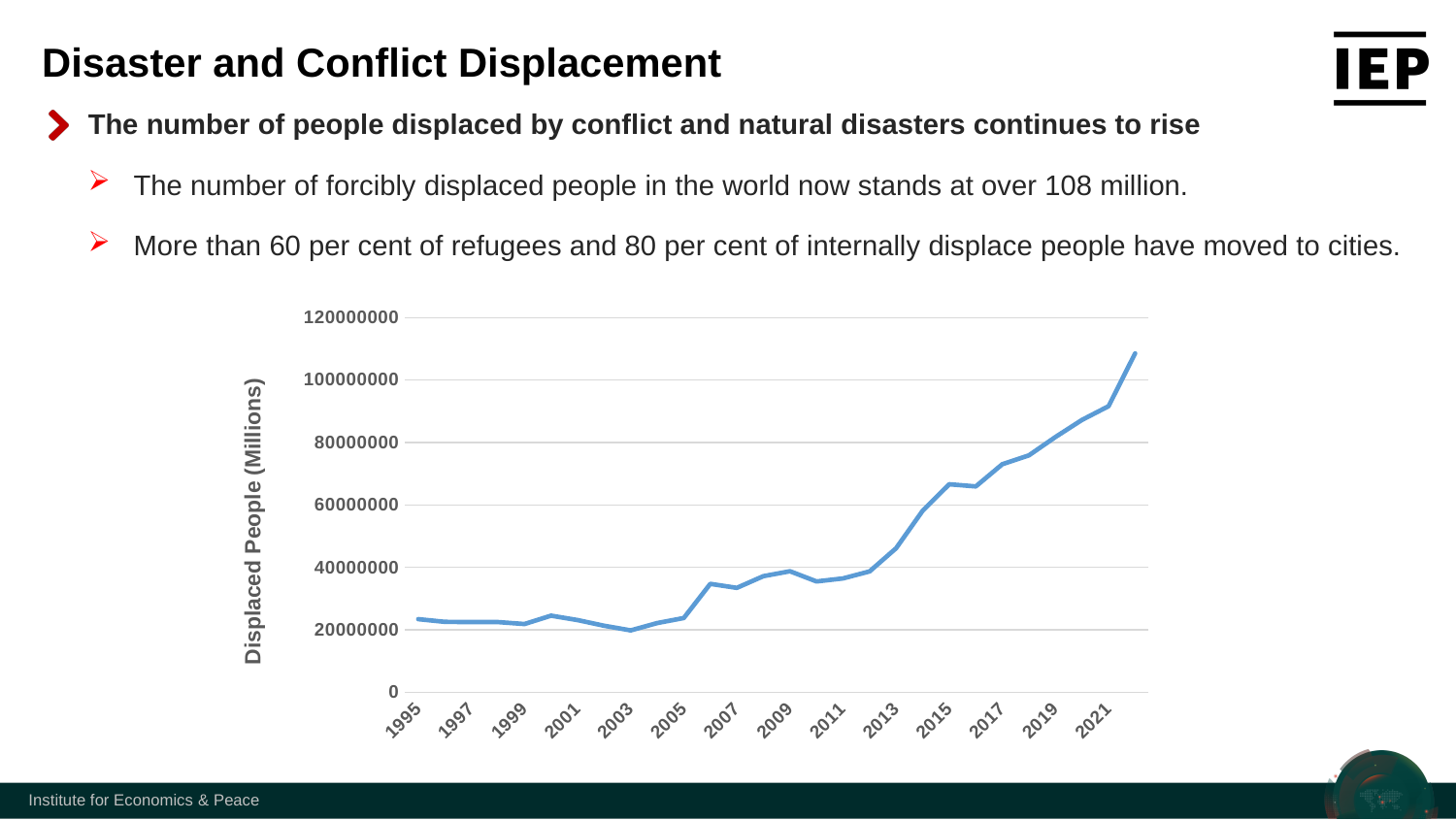
Overall, do the values on the chart rise or fall from 1995 to the end of the series? rise Is the value for 2013 greater or less than 40000000? greater Is the value for 2005 greater or less than 40000000? less Is the value for 2017 greater or less than 60000000? greater What is the title of the y axis on the chart? Displaced People (Millions) How many year labels are shown on the x axis of the chart? 14 Which is larger, the value for 2015 or the value for 2005? 2015 What kind of chart is shown on the slide? line chart Which labelled year on the x axis has the lowest number of displaced people? 2003